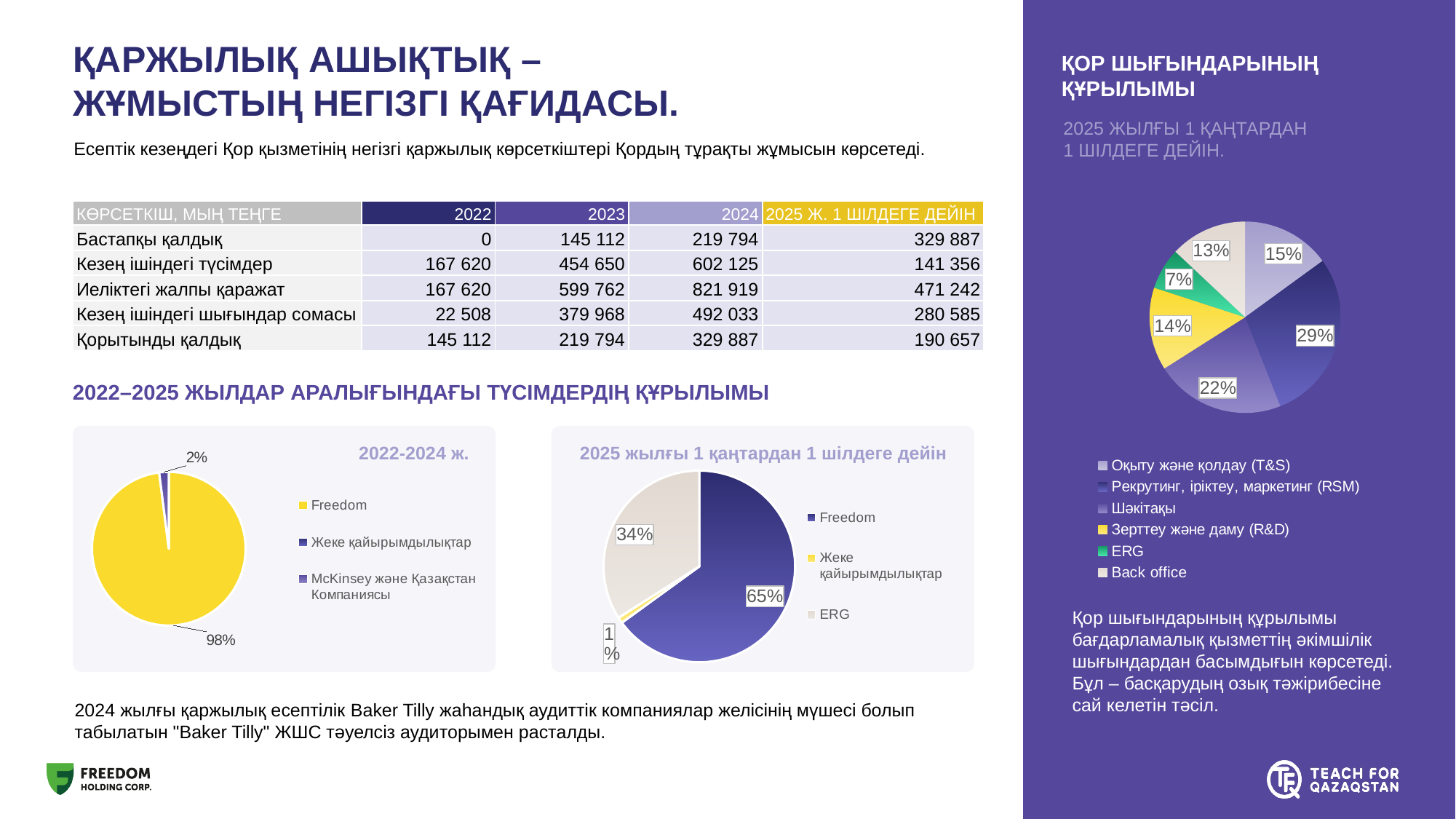
In the pie chart titled "2022-2024 ж.", which category has the largest slice? Freedom In the pie chart titled "2025 жылғы 1 қаңтардан 1 шілдеге дейін", what share does Freedom have? 65% In the pie chart on the right of the slide ("ҚОР ШЫҒЫНДАРЫНЫҢ ҚҰРЫЛЫМЫ"), how many categories does the legend list? 6 In the pie chart on the right of the slide ("ҚОР ШЫҒЫНДАРЫНЫҢ ҚҰРЫЛЫМЫ"), which category has the smallest slice? ERG In the pie chart titled "2022-2024 ж.", what share does Freedom have? 98% What kind of chart is used under the heading "ҚОР ШЫҒЫНДАРЫНЫҢ ҚҰРЫЛЫМЫ" on the right of the slide? Pie chart In the pie chart on the right of the slide ("ҚОР ШЫҒЫНДАРЫНЫҢ ҚҰРЫЛЫМЫ"), what share does ERG have? 7% In the pie chart on the right of the slide ("ҚОР ШЫҒЫНДАРЫНЫҢ ҚҰРЫЛЫМЫ"), what share does Рекрутинг, іріктеу, маркетинг (RSM) have? 29% In the pie chart titled "2022-2024 ж.", how many entries does the legend list? 3 In the pie chart titled "2025 жылғы 1 қаңтардан 1 шілдеге дейін", what is the difference between the Freedom share and the ERG share? 31% In the pie chart titled "2025 жылғы 1 қаңтардан 1 шілдеге дейін", which category has the smallest slice? Жеке қайырымдылықтар In the pie chart titled "2025 жылғы 1 қаңтардан 1 шілдеге дейін", what share does ERG have? 34%